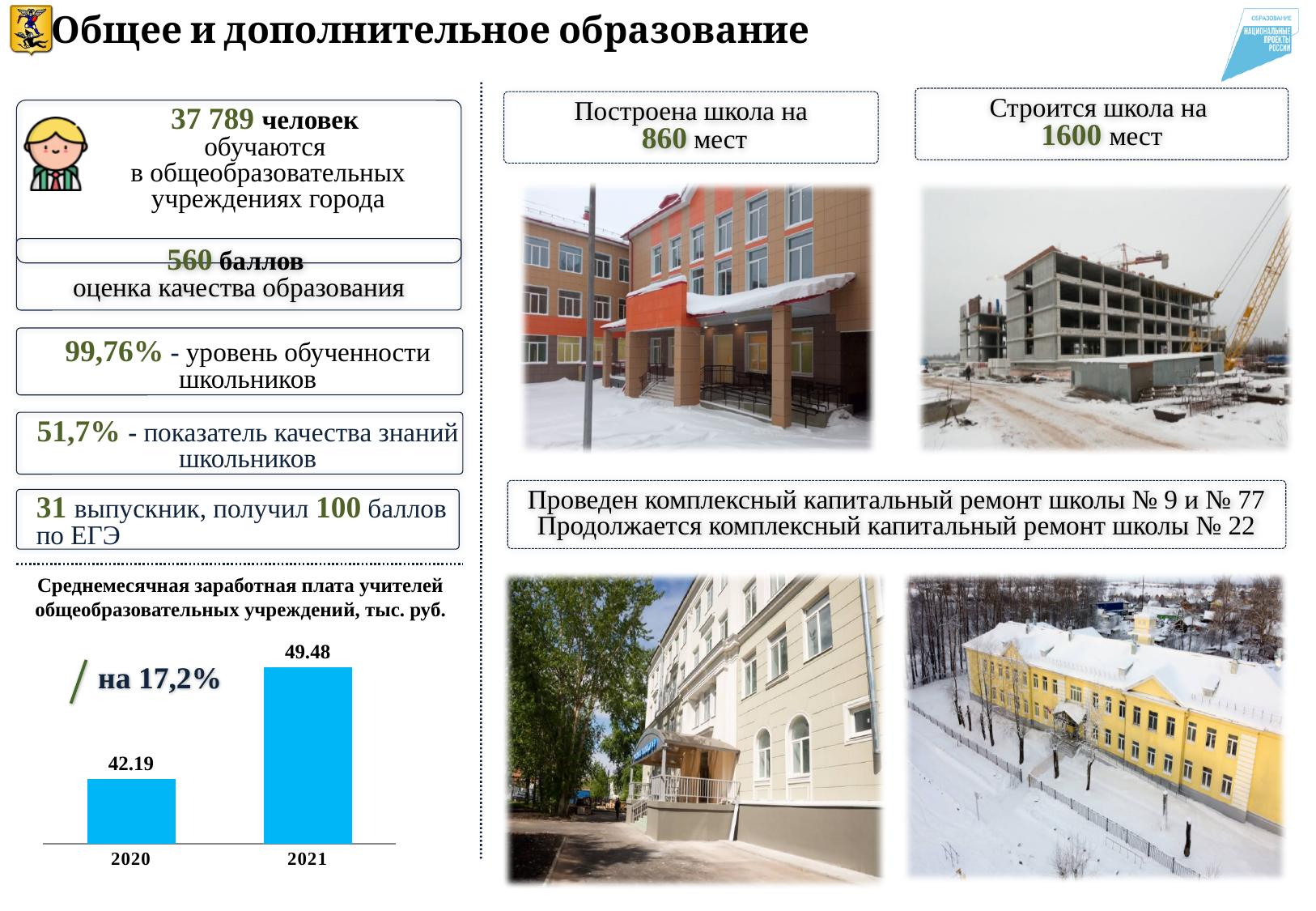
What kind of chart is used to show the average monthly teacher salary? bar chart Do the values in the teacher salary chart rise or fall from 2020 to 2021? rise What percentage increase is annotated on the teacher salary chart? на 17,2% In what units are the values of the teacher salary chart given, according to its title? тыс. руб. What is the value for 2020 in the chart of average monthly teacher salary? 42.19 What is the value for 2021 in the chart of average monthly teacher salary? 49.48 How many bars are shown in the teacher salary chart? 2 What is the difference between the 2021 and 2020 values in the teacher salary chart? 7.29 Which year has the higher value in the teacher salary chart? 2021 Is the value for 2021 larger or smaller than the value for 2020 in the teacher salary chart? larger Which year has the lower value in the teacher salary chart? 2020